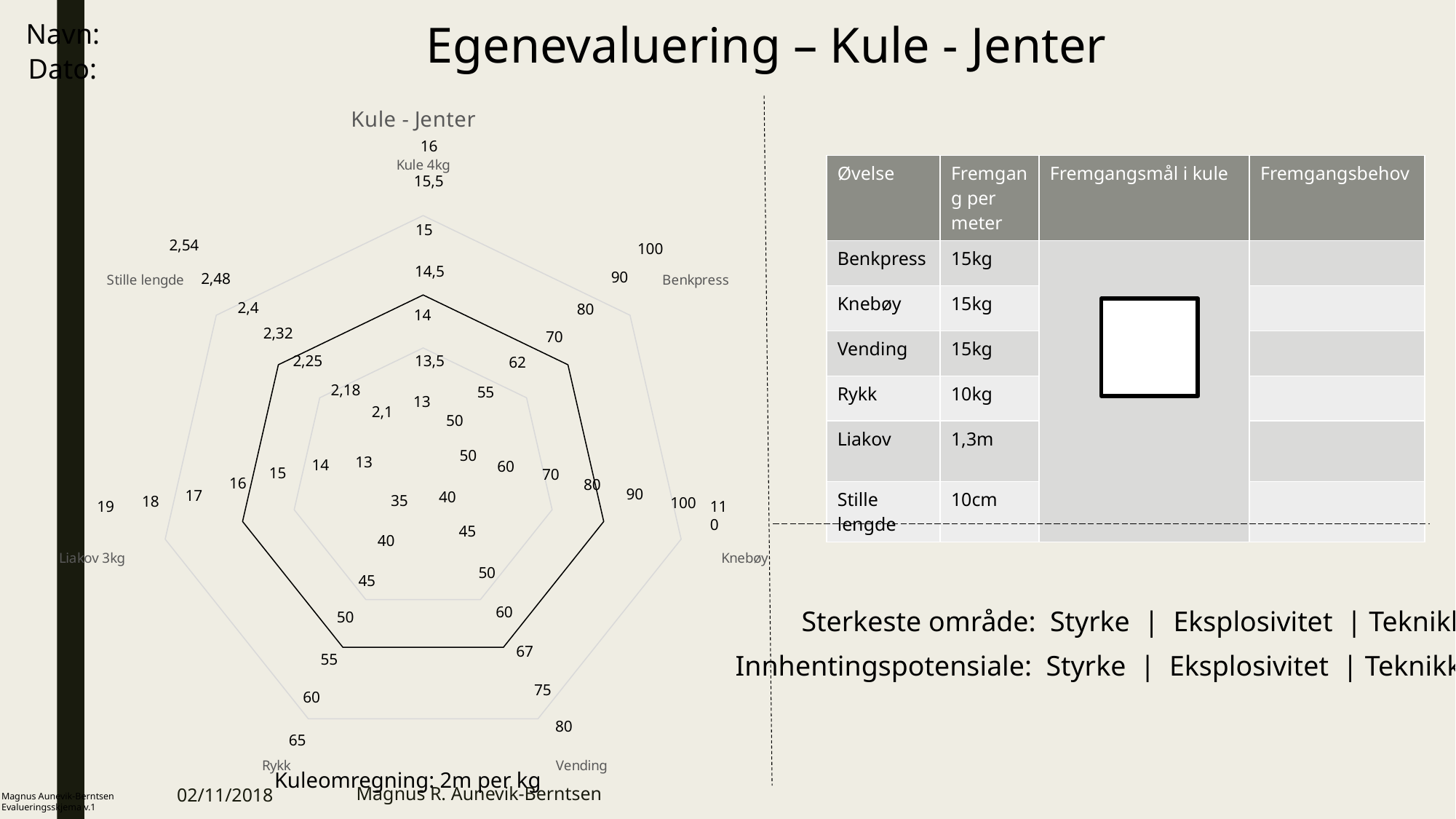
Is the plotted value for Vending greater or less than 80? less Is the plotted value for Knebøy greater or less than 100? less What is the title of the chart? Kule - Jenter Is the plotted value for Kule 4kg greater or less than 13? greater Which category label appears at the top axis of the radar chart? Kule 4kg How many categories (axes) does the radar chart have? 7 What kind of chart is shown on the slide? Radar chart